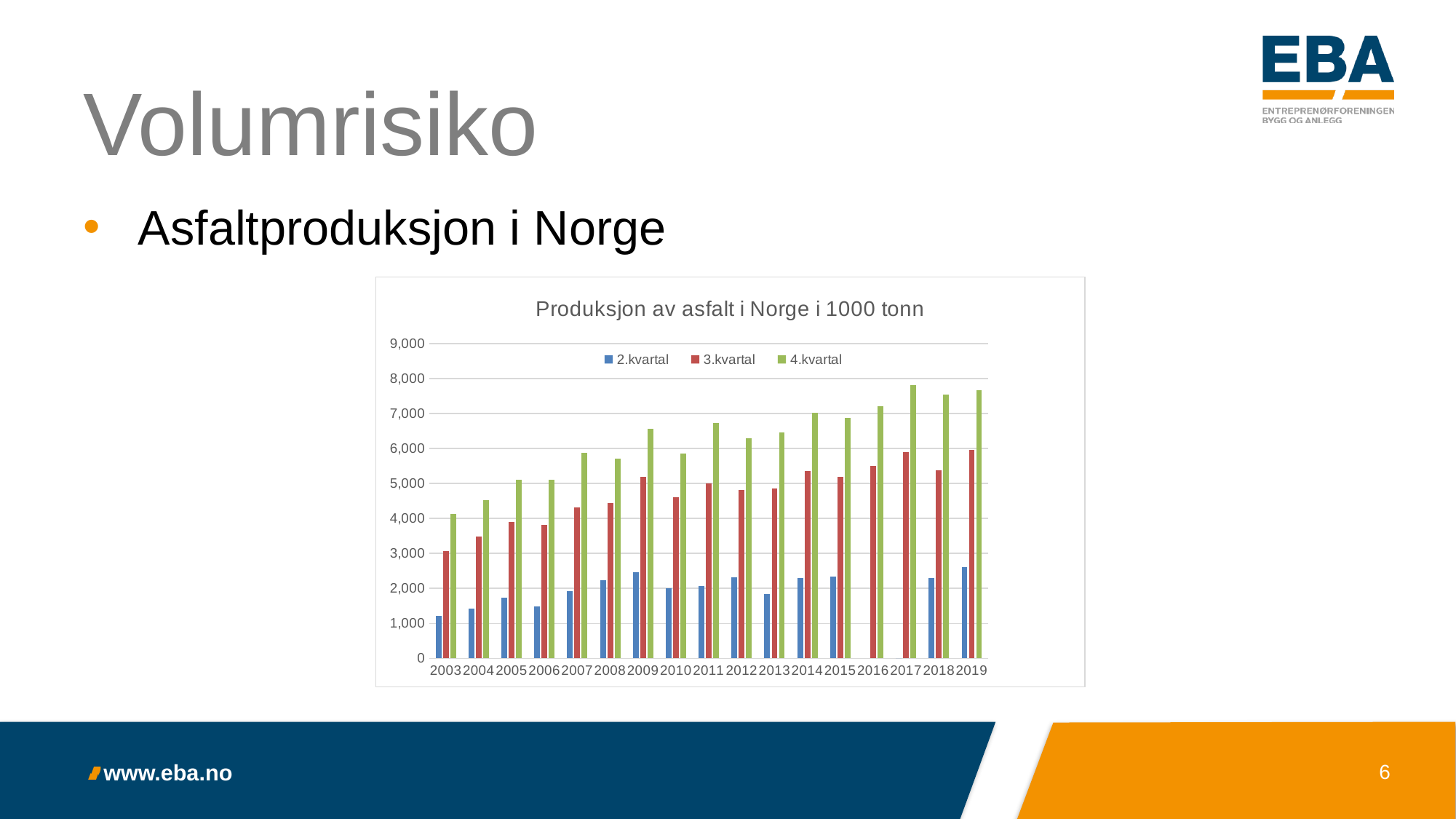
Does the 4.kvartal series generally rise or fall from 2003 to 2019? rise How many years are shown on the x axis? 17 How many series does the legend list? 3 In which year is the 4.kvartal value highest? 2017 What kind of chart is shown on the slide? bar chart Which is larger, the 3.kvartal value for 2017 or for 2018? 2017 Is the 2.kvartal value for 2019 greater or less than 2,000? greater Is the 4.kvartal value for 2019 greater or less than 7,000? greater What is the title of the chart? Produksjon av asfalt i Norge i 1000 tonn Is the 3.kvartal value for 2004 greater or less than 4,000? less In which year is the 4.kvartal value lowest? 2003